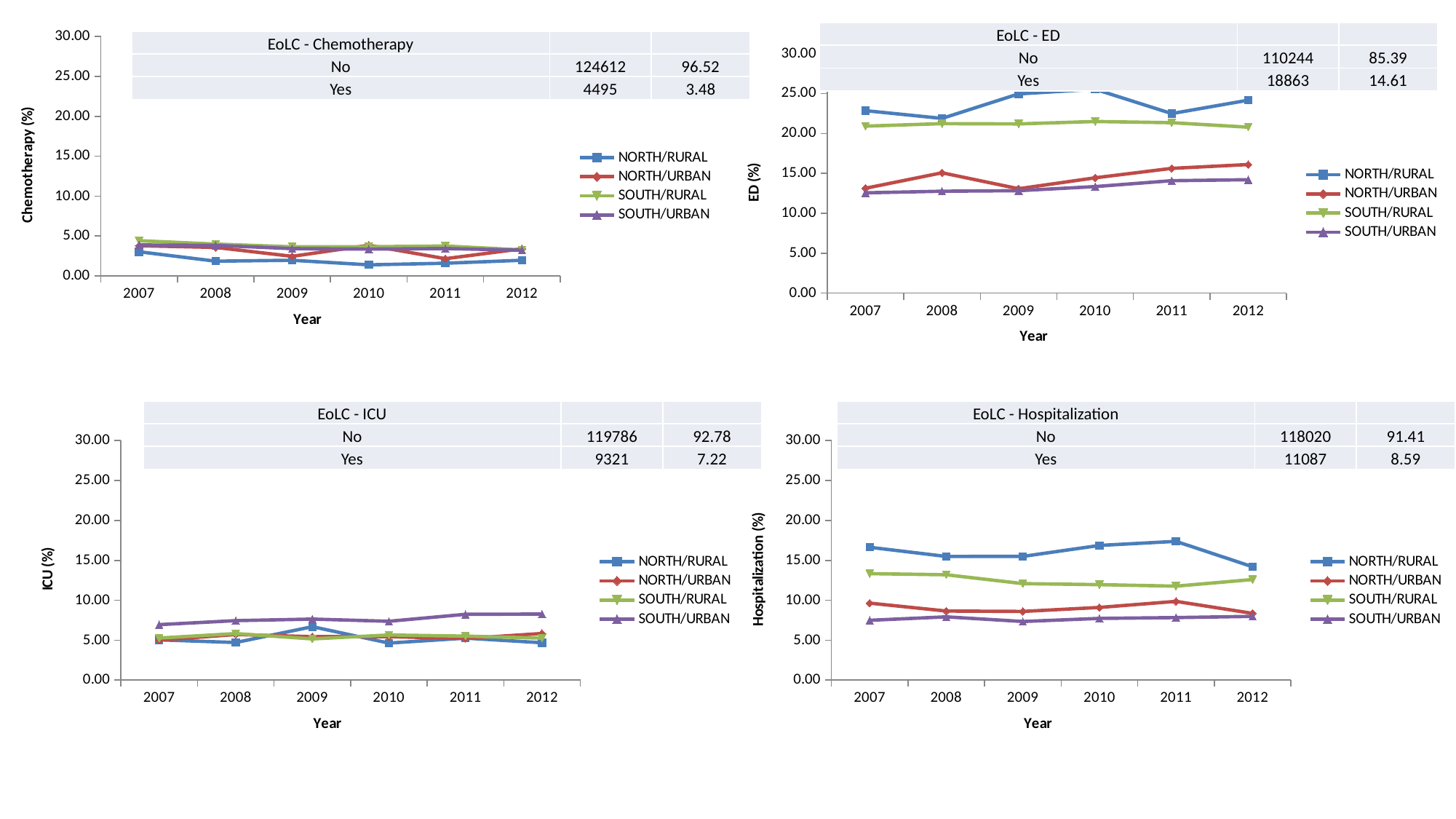
How many years are shown on the x axis of the EoLC - ICU chart? 6 In the EoLC - ED chart, is the value for SOUTH/URBAN in 2007 greater or less than 15.00? less In the EoLC - ICU chart, which series has the highest value in 2012? SOUTH/URBAN How many series does the legend of the EoLC - Chemotherapy chart list? 4 In the EoLC - ED chart, does the NORTH/URBAN line rise or fall from 2009 to 2012? rise In the EoLC - Chemotherapy chart, is the value for NORTH/RURAL in 2010 greater or less than 5.00? less In the EoLC - Hospitalization chart, which series has the lowest value in 2007? SOUTH/URBAN In the EoLC - ED chart, is the value for NORTH/RURAL in 2009 greater or less than 20.00? greater What kind of chart is the EoLC - ED chart? line chart In the EoLC - Hospitalization chart, which series has the highest value in 2007? NORTH/RURAL In the EoLC - ED chart, which is larger in 2012: NORTH/RURAL or SOUTH/RURAL? NORTH/RURAL